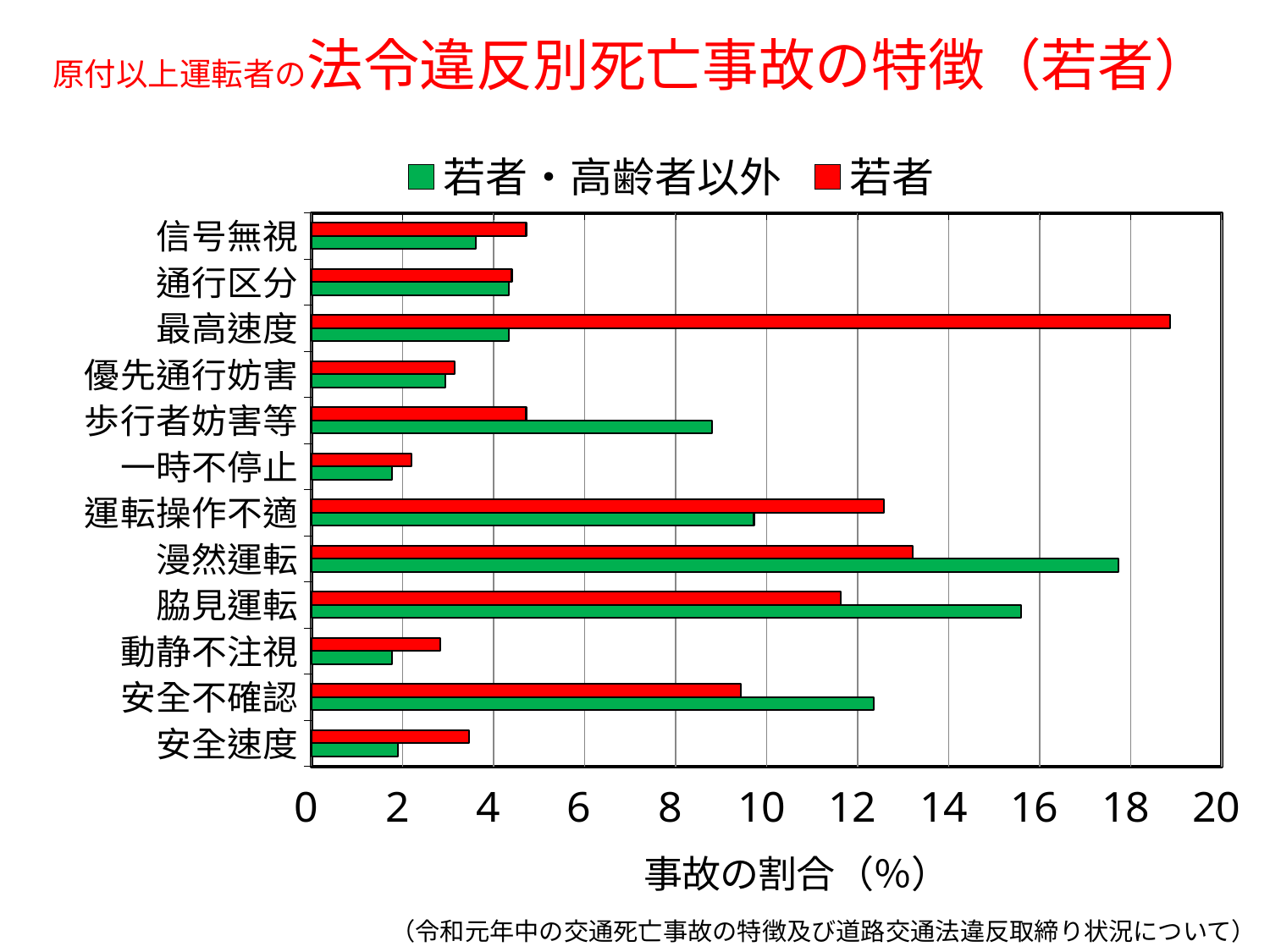
Is the 若者・高齢者以外 value for 漫然運転 greater or less than 16? greater Is the 若者 value for 一時不停止 greater or less than 4? less What is the label of the x axis? 事故の割合（%） How many series does the legend list? 2 For 運転操作不適, which series has the larger value, 若者 or 若者・高齢者以外? 若者 Which colour represents the 若者 series in the legend? red Which category has the highest value for the 若者 series? 最高速度 For 脇見運転, which series has the larger value, 若者 or 若者・高齢者以外? 若者・高齢者以外 Is the 若者 value for 最高速度 greater or less than 18? greater How many violation categories are plotted on the y axis? 12 Which category has the highest value for the 若者・高齢者以外 series? 漫然運転 What kind of chart is shown on the slide? bar chart